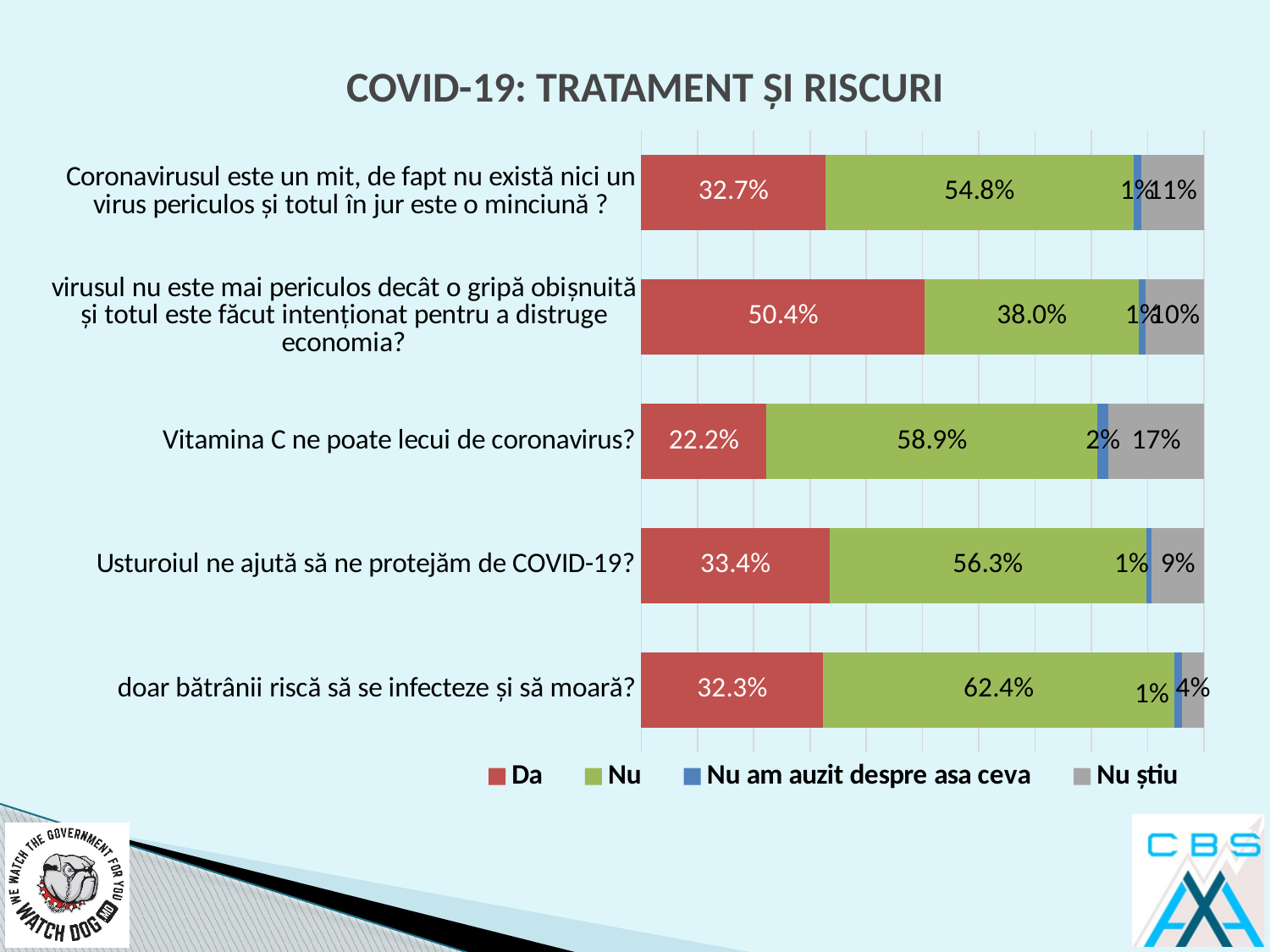
For "Usturoiul ne ajută să ne protejăm de COVID-19?", how many percentage points higher is "Nu" than "Da"? 22.9 percentage points Is the "Da" value larger for "Coronavirusul este un mit..." or for "Usturoiul ne ajută să ne protejăm de COVID-19?"? Usturoiul ne ajută să ne protejăm de COVID-19? How many statements (categories) are shown in the chart? 5 Which statement has the highest "Nu" percentage? doar bătrânii riscă să se infecteze și să moară? What type of chart is shown on the slide? Stacked bar chart What percentage answered "Nu" to "doar bătrânii riscă să se infecteze și să moară?"? 62.4% Which statement has the highest "Da" percentage? virusul nu este mai periculos decât o gripă obișnuită și totul este făcut intenționat pentru a distruge economia? What percentage answered "Da" to "Vitamina C ne poate lecui de coronavirus?"? 22.2% What is the "Nu știu" share for "Vitamina C ne poate lecui de coronavirus?"? 17% What is the "Da" value for "Usturoiul ne ajută să ne protejăm de COVID-19?"? 33.4% How many series does the legend list? 4 Which statement has the lowest "Da" percentage? Vitamina C ne poate lecui de coronavirus?